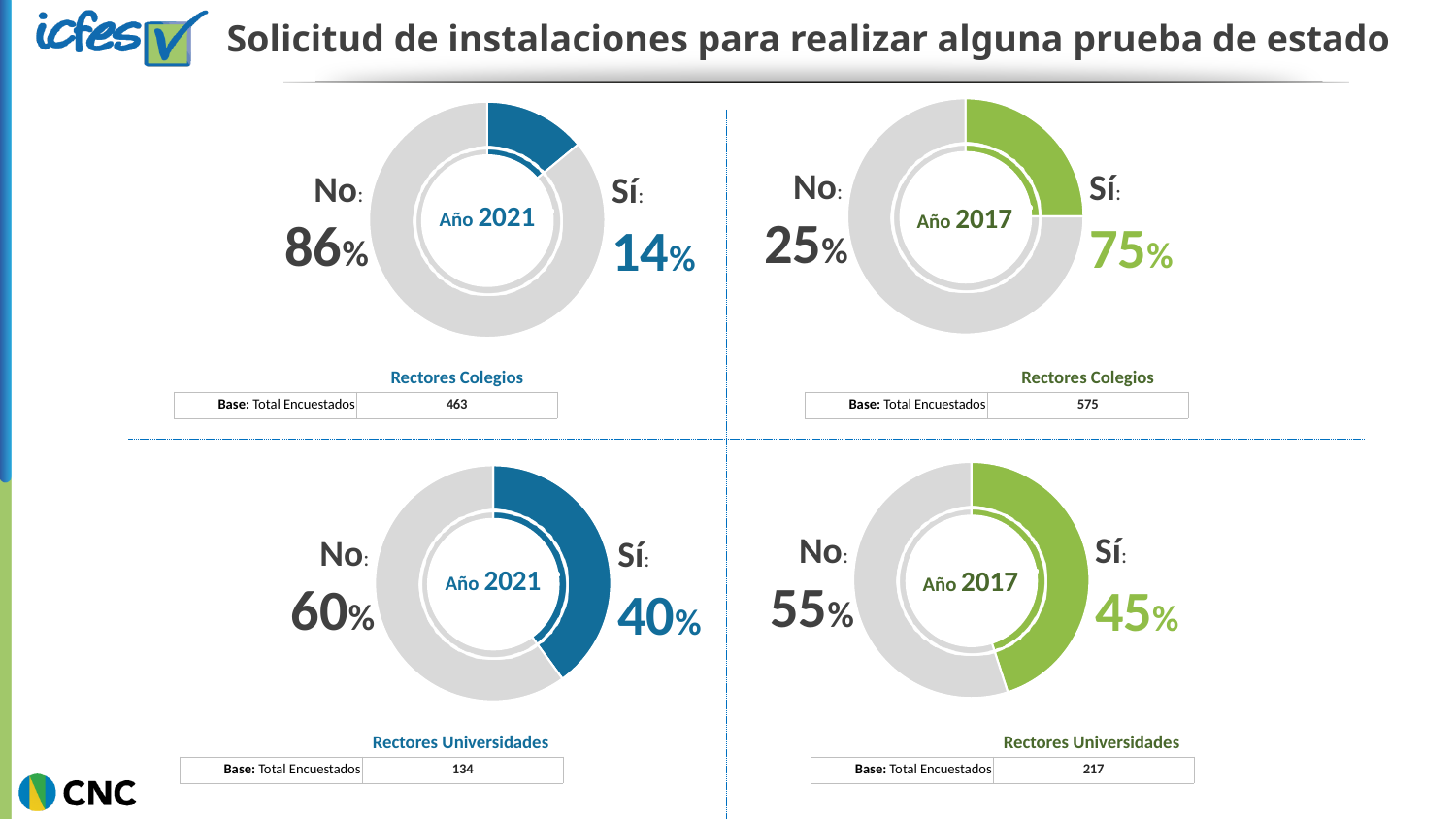
In the bottom-left chart (Rectores Universidades, Año 2021), which answer has the smaller share? Sí What is the difference between the Sí share in the top-right chart (Rectores Colegios, Año 2017) and the Sí share in the top-left chart (Rectores Colegios, Año 2021)? 61 percentage points In the top-left chart (Rectores Colegios, Año 2021), what percentage answered Sí? 14% In the top-right chart (Rectores Colegios, Año 2017), what percentage answered Sí? 75% How many charts are shown on the slide? 4 In the top-right chart (Rectores Colegios, Año 2017), which answer has the larger share, Sí or No? Sí In the bottom-left chart (Rectores Universidades, Año 2021), what percentage answered No? 60% What kind of chart is used on this slide? Pie (donut) chart In the top-left chart (Rectores Colegios, Año 2021), what percentage answered No? 86% What is the base (Total Encuestados) shown under the bottom-left chart (Rectores Universidades, Año 2021)? 134 What is the difference between the No share and the Sí share in the bottom-right chart (Rectores Universidades, Año 2017)? 10 percentage points In the bottom-right chart (Rectores Universidades, Año 2017), what percentage answered Sí? 45%